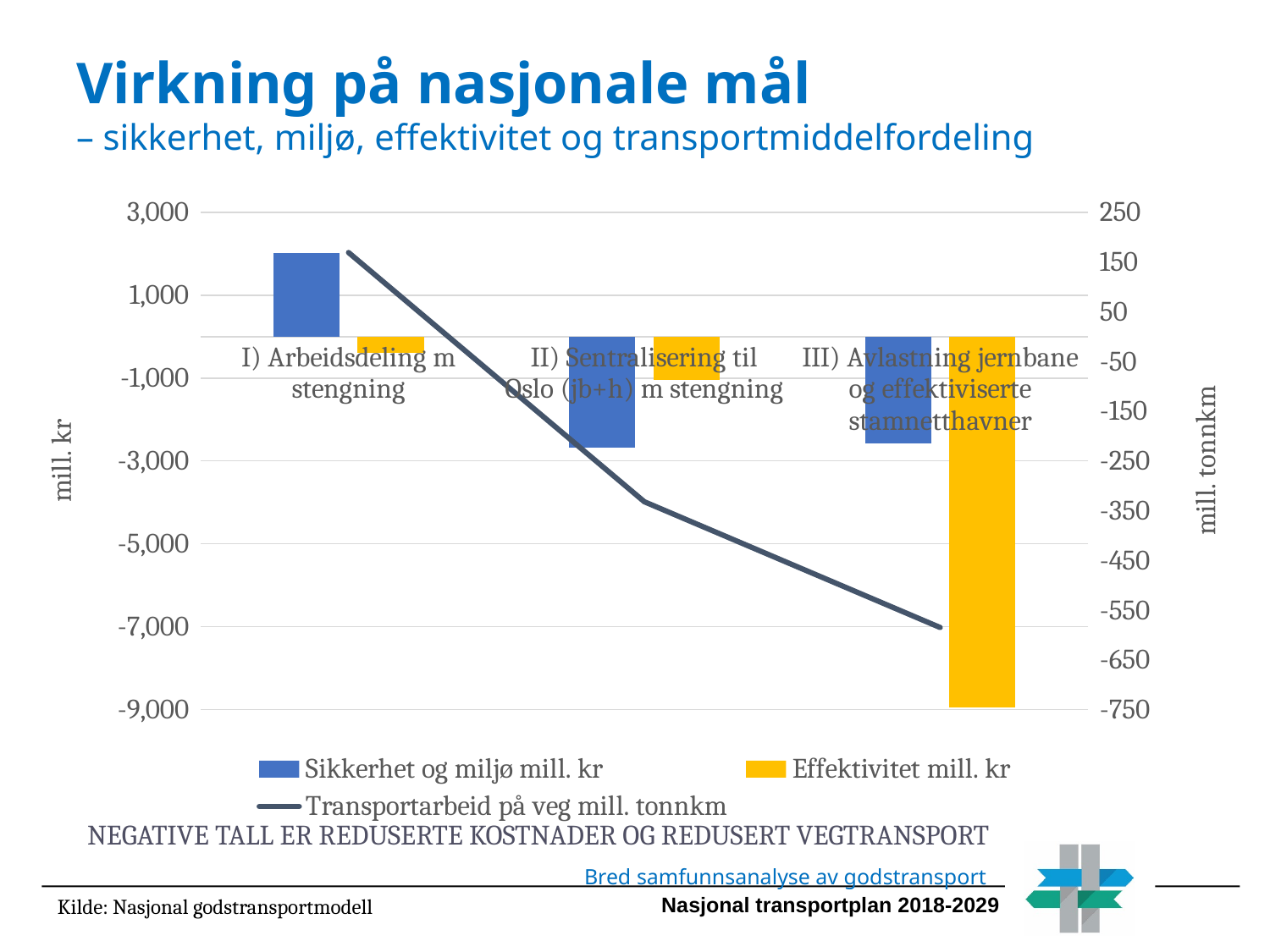
Which category has the highest value for Sikkerhet og miljø mill. kr? I) Arbeidsdeling m stengning Is the Effektivitet mill. kr value for III) Avlastning jernbane og effektiviserte stamnetthavner greater or less than -7,000? less Is the Transportarbeid på veg mill. tonnkm value for III) Avlastning jernbane og effektiviserte stamnetthavner greater or less than -450? less How many categories are shown on the x axis of the chart? 3 What is the label of the right-hand vertical axis of the chart? mill. tonnkm Is the Sikkerhet og miljø mill. kr value for II) Sentralisering til Oslo (jb+h) m stengning greater or less than -1,000? less Does the Transportarbeid på veg mill. tonnkm line rise or fall from category I to category III? It falls Which is larger, the Effektivitet mill. kr value for II) Sentralisering til Oslo (jb+h) m stengning or for III) Avlastning jernbane og effektiviserte stamnetthavner? II) Sentralisering til Oslo (jb+h) m stengning How many series does the chart's legend list? 3 Which category has the lowest value for Effektivitet mill. kr? III) Avlastning jernbane og effektiviserte stamnetthavner What kind of chart is shown on the slide? A combined bar and line chart